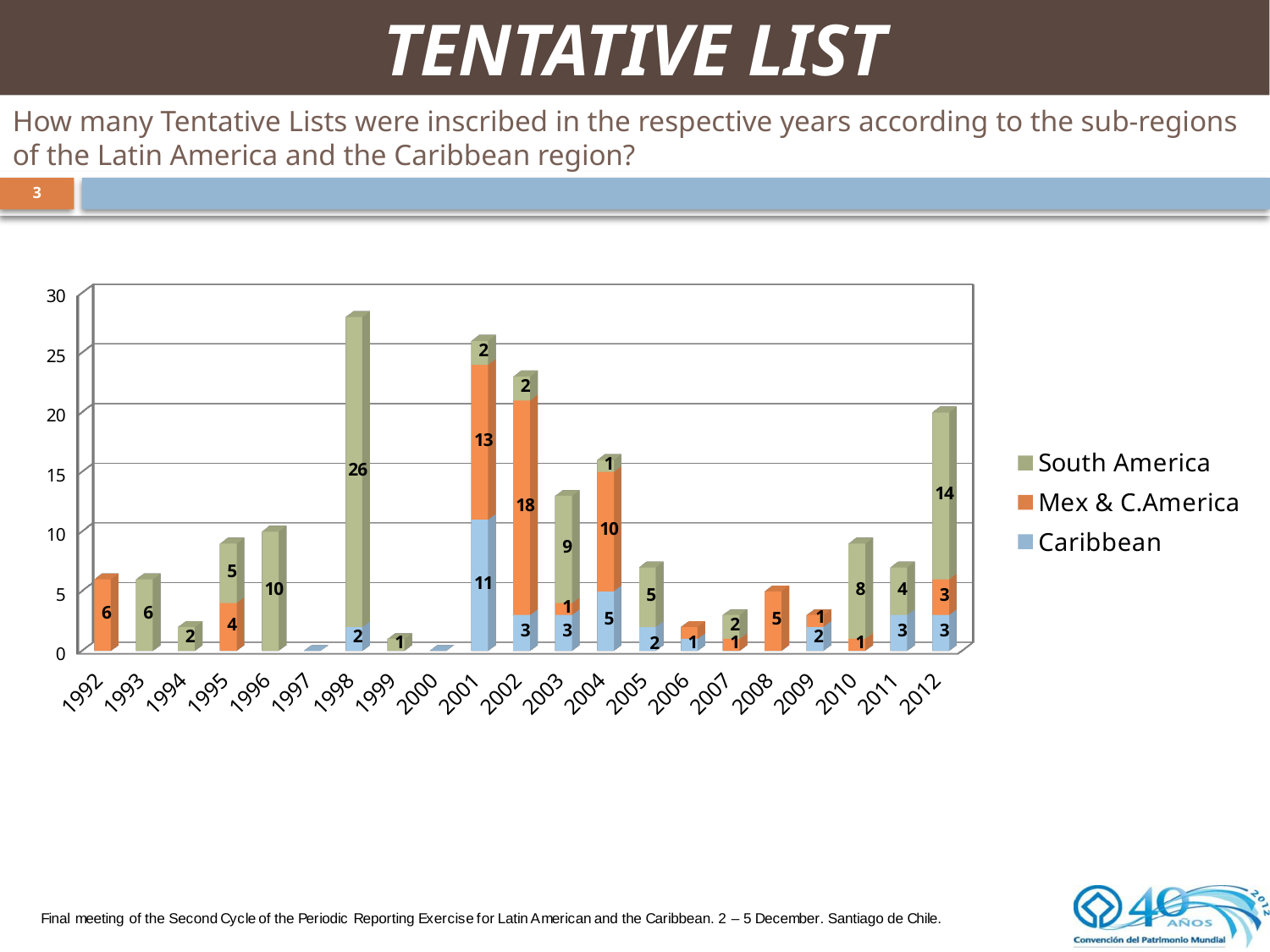
Which series is shown in orange in the legend? Mex & C.America Which year has the highest South America value? 1998 Is the total of the stacked bar for 1998 greater or less than 25? greater What is the South America value for 1998? 26 What is the total of the stacked bar for 2001? 26 What is the difference between the Mex & C.America values for 2002 and 2004? 8 Which is larger, the South America value for 2010 or the South America value for 2011? 2010 What is the Caribbean value for 2001? 11 What is the Mex & C.America value for 2002? 18 How many series does the legend list? 3 What type of chart is shown on the slide? stacked bar chart What is the total of the stacked bar for 2012? 20